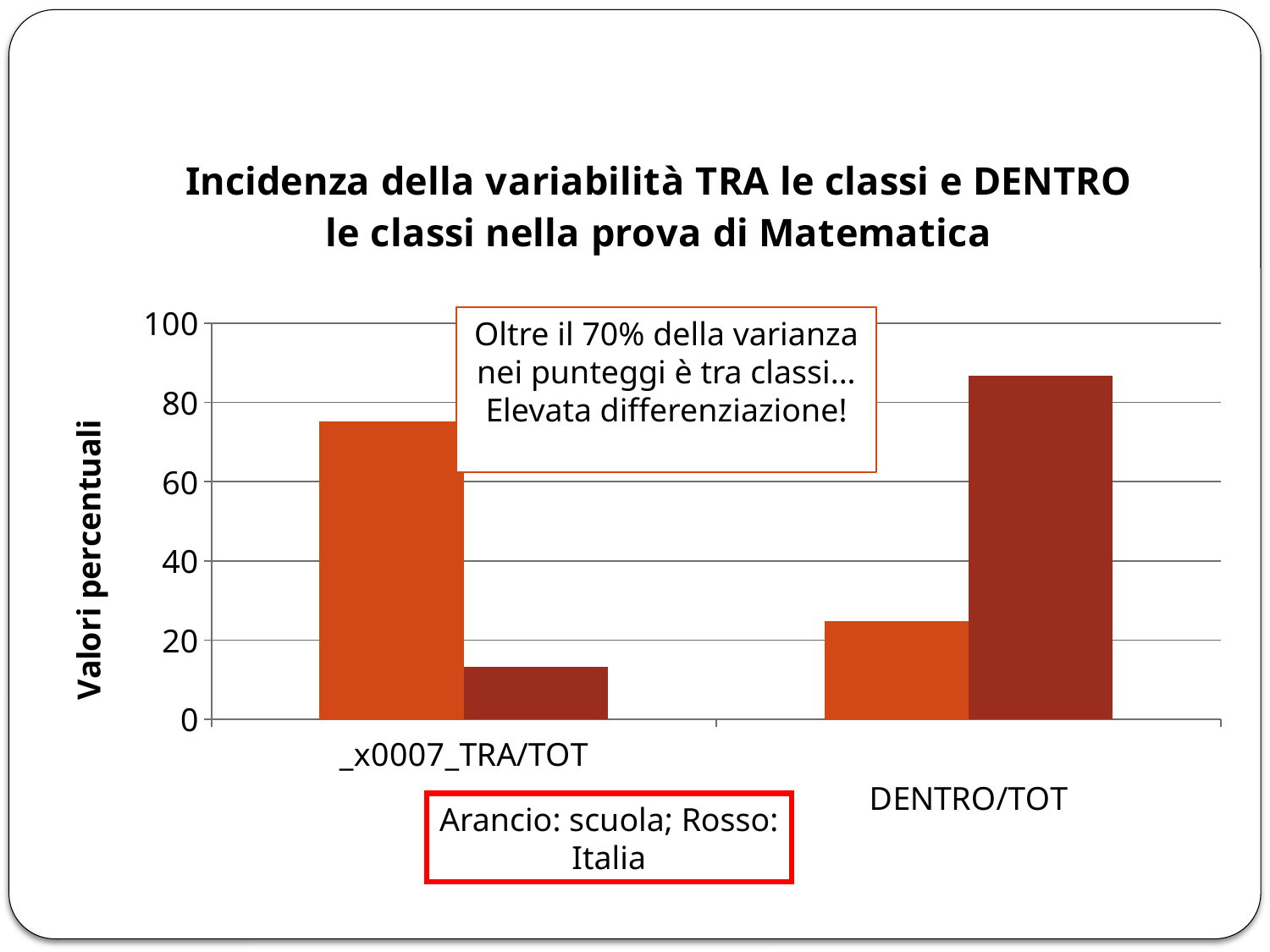
According to the slide, which series does the orange colour represent? scuola How many series are plotted in the chart? 2 Is the orange (scuola) bar for DENTRO/TOT greater or less than 40? less Is the red (Italia) bar for DENTRO/TOT greater or less than 80? greater Is the orange (scuola) bar for _x0007_TRA/TOT greater or less than 60? greater What is the title of the y axis? Valori percentuali Which bar is the tallest in the chart? Italia (red) for DENTRO/TOT What kind of chart is shown on the slide? bar chart For the orange (scuola) series, which category has the larger value: _x0007_TRA/TOT or DENTRO/TOT? _x0007_TRA/TOT How many categories are shown on the x axis of the chart? 2 Which bar is the shortest in the chart? Italia (red) for _x0007_TRA/TOT